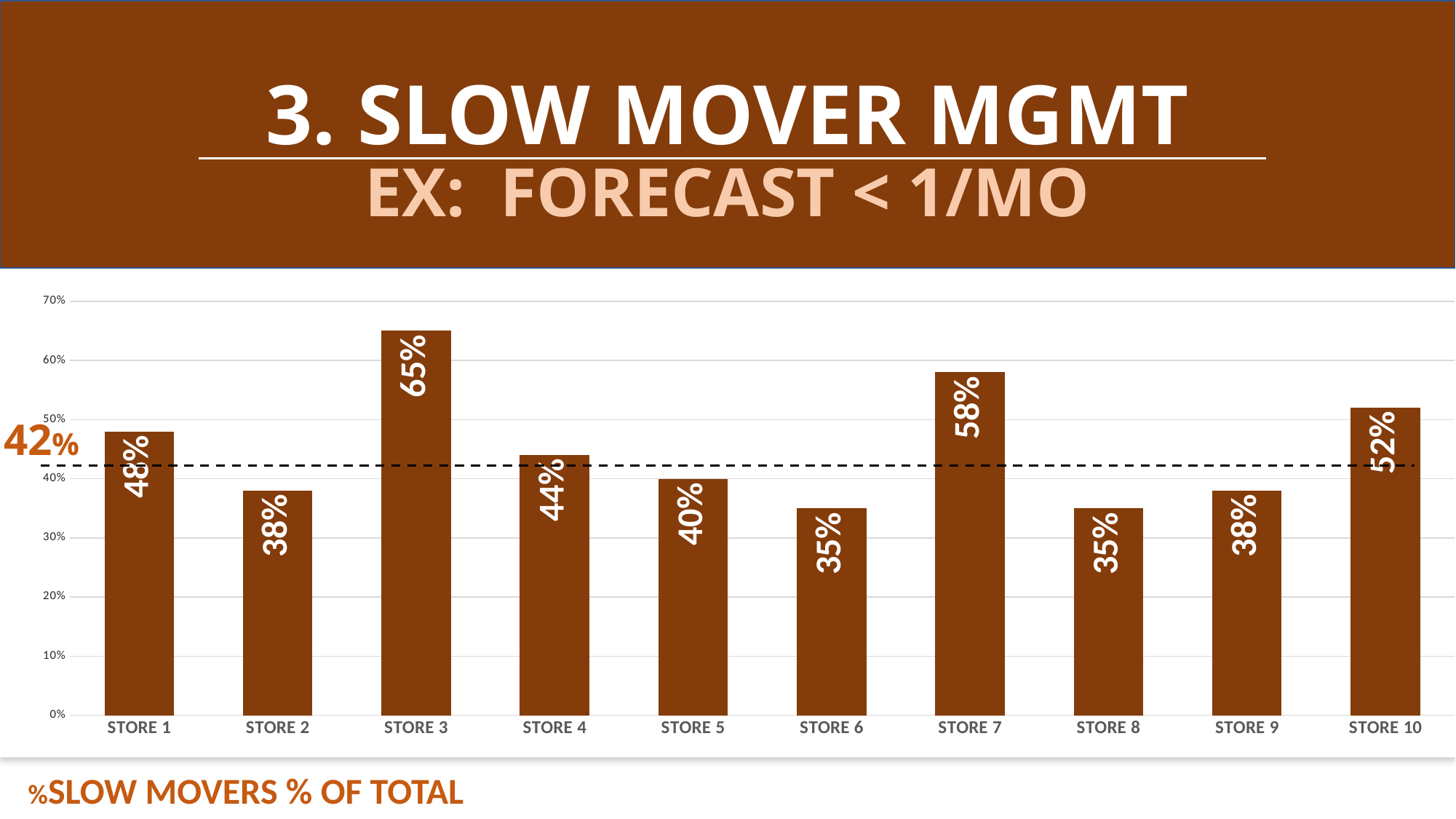
How many stores are shown on the chart? 10 What kind of chart is shown on the slide? bar chart Which store has the highest slow movers percentage? STORE 3 What is the slow movers percentage for STORE 3? 65% What is the value shown for STORE 10? 52% What value does the dashed horizontal line on the chart mark? 42% Is the value for STORE 9 greater or less than 40%? less What is the difference between the values for STORE 3 and STORE 7? 7% Which is larger, the value for STORE 4 or the value for STORE 5? STORE 4 Which stores share the lowest slow movers percentage? STORE 6 and STORE 8 What is the difference between the values for STORE 1 and STORE 2? 10% What is the slow movers percentage for STORE 7? 58%